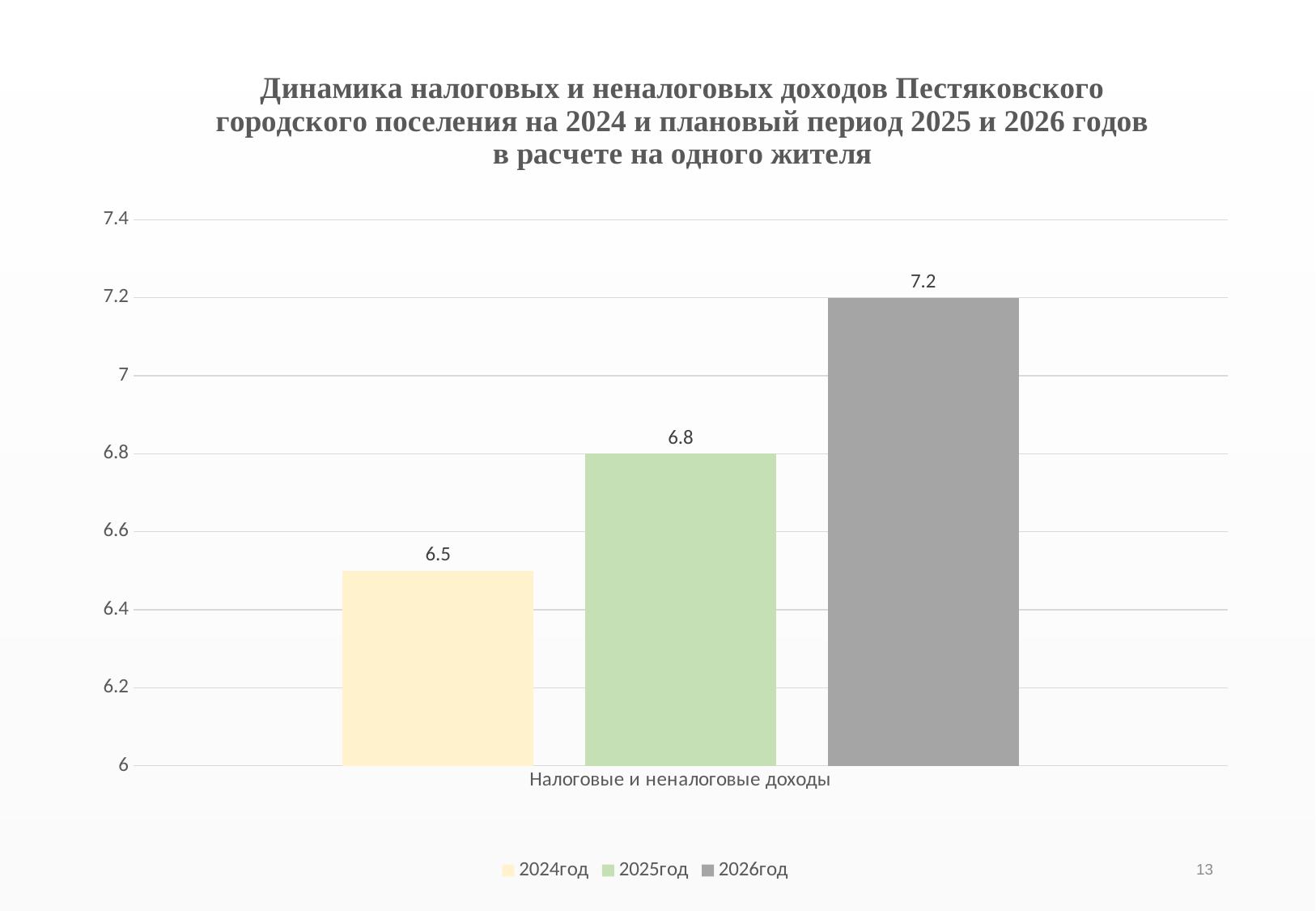
What is the value for 2024год (2024 year) in the chart? 6.5 How many series does the legend list? 3 Which year has the highest value in the chart? 2026год What is the difference between the values for 2025год and 2024год? 0.3 Do the values rise or fall from 2024год to 2026год? rise What is the difference between the values for 2026год and 2024год? 0.7 Which is larger, the value for 2025год or the value for 2026год? 2026год Which year has the lowest value in the chart? 2024год What is the value for 2025год (2025 year) in the chart? 6.8 What is the value for 2026год (2026 year) in the chart? 7.2 Is the value for 2025год greater or less than 7? less What kind of chart is shown on the slide? bar chart